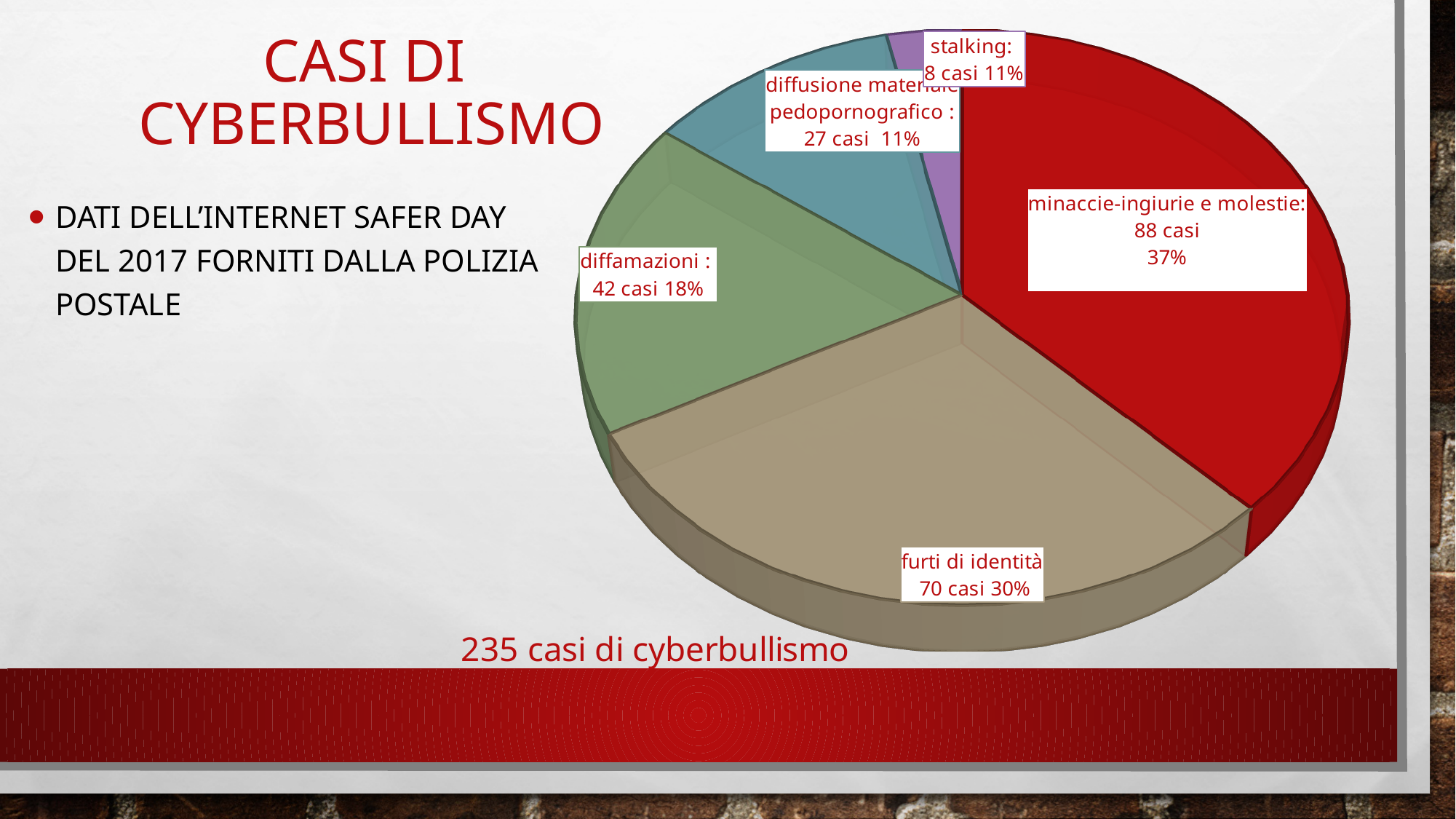
How many cases are shown for "furti di identità"? 70 casi What share of the pie does "minaccie-ingiurie e molestie" represent? 37% How many cases are shown for "minaccie-ingiurie e molestie"? 88 casi How many slices does the pie chart have? 5 How many cases are shown for "diffusione materiale pedopornografico"? 27 casi What kind of chart is shown on the slide? pie chart Which category has the smallest slice of the pie? stalking What share of the pie does "furti di identità" represent? 30% What is the difference in cases between "minaccie-ingiurie e molestie" and "furti di identità"? 18 casi How many cases are shown for "diffamazioni"? 42 casi Which category has the largest slice of the pie? minaccie-ingiurie e molestie What total number of cyberbullying cases is stated below the pie chart? 235 casi di cyberbullismo